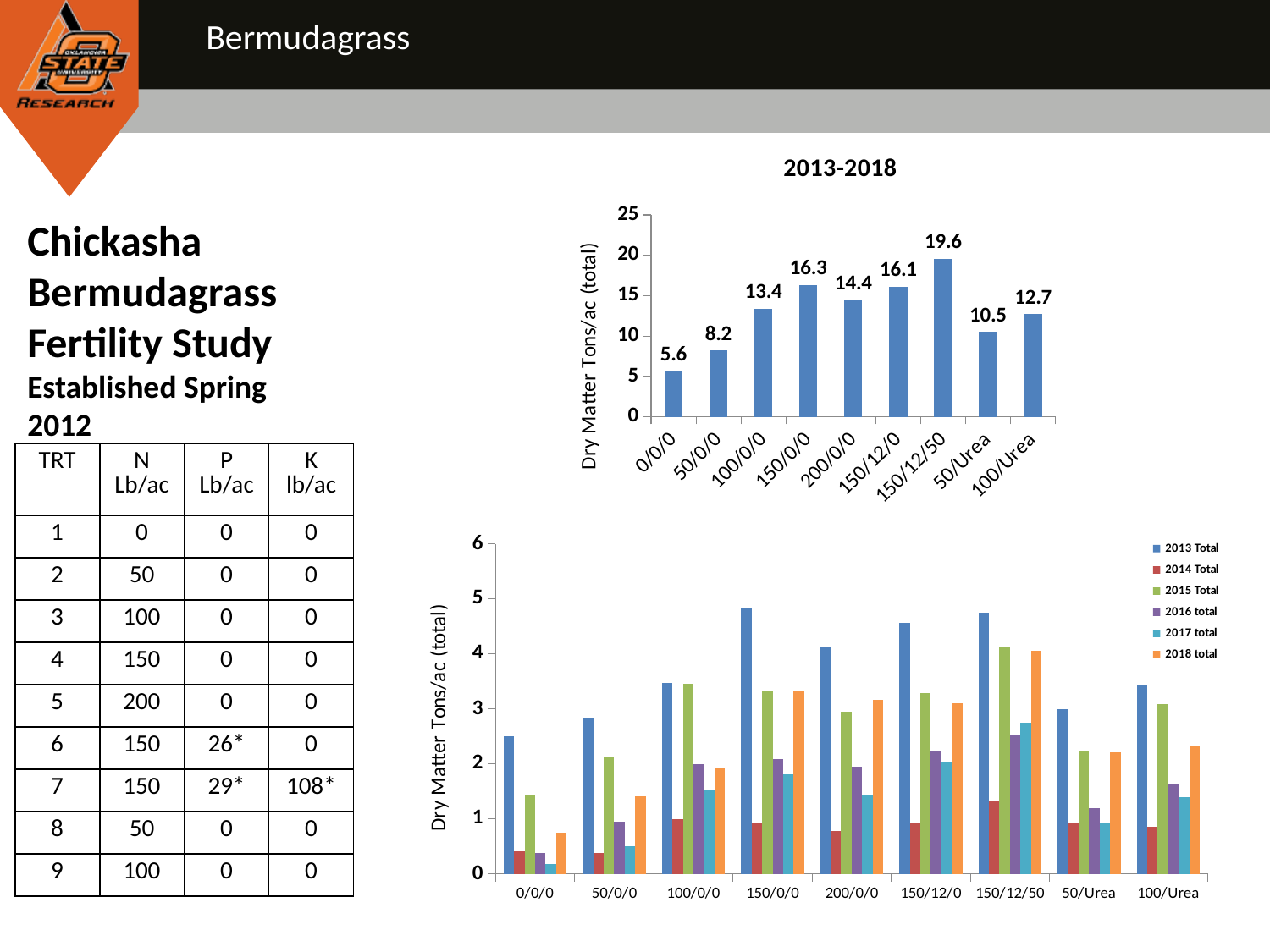
In the bottom chart, is the 2013 Total value for 150/0/0 greater or less than 4? greater In the 2013-2018 chart, what is the value for 50/Urea? 10.5 What is the y-axis label of the bottom chart? Dry Matter Tons/ac (total) In the 2013-2018 chart, what is the value for 150/12/50? 19.6 In the 2013-2018 chart, which is larger, the value for 200/0/0 or the value for 100/Urea? 200/0/0 What type of chart is the 2013-2018 chart? bar chart How many series does the legend of the bottom chart list? 6 How many categories are shown in the 2013-2018 chart? 9 In the 2013-2018 chart, which category has the highest value? 150/12/50 In the 2013-2018 chart, what is the difference between the values for 150/0/0 and 100/0/0? 2.9 In the bottom chart, is the 2014 Total value for 0/0/0 greater or less than 1? less In the 2013-2018 chart, which category has the lowest value? 0/0/0